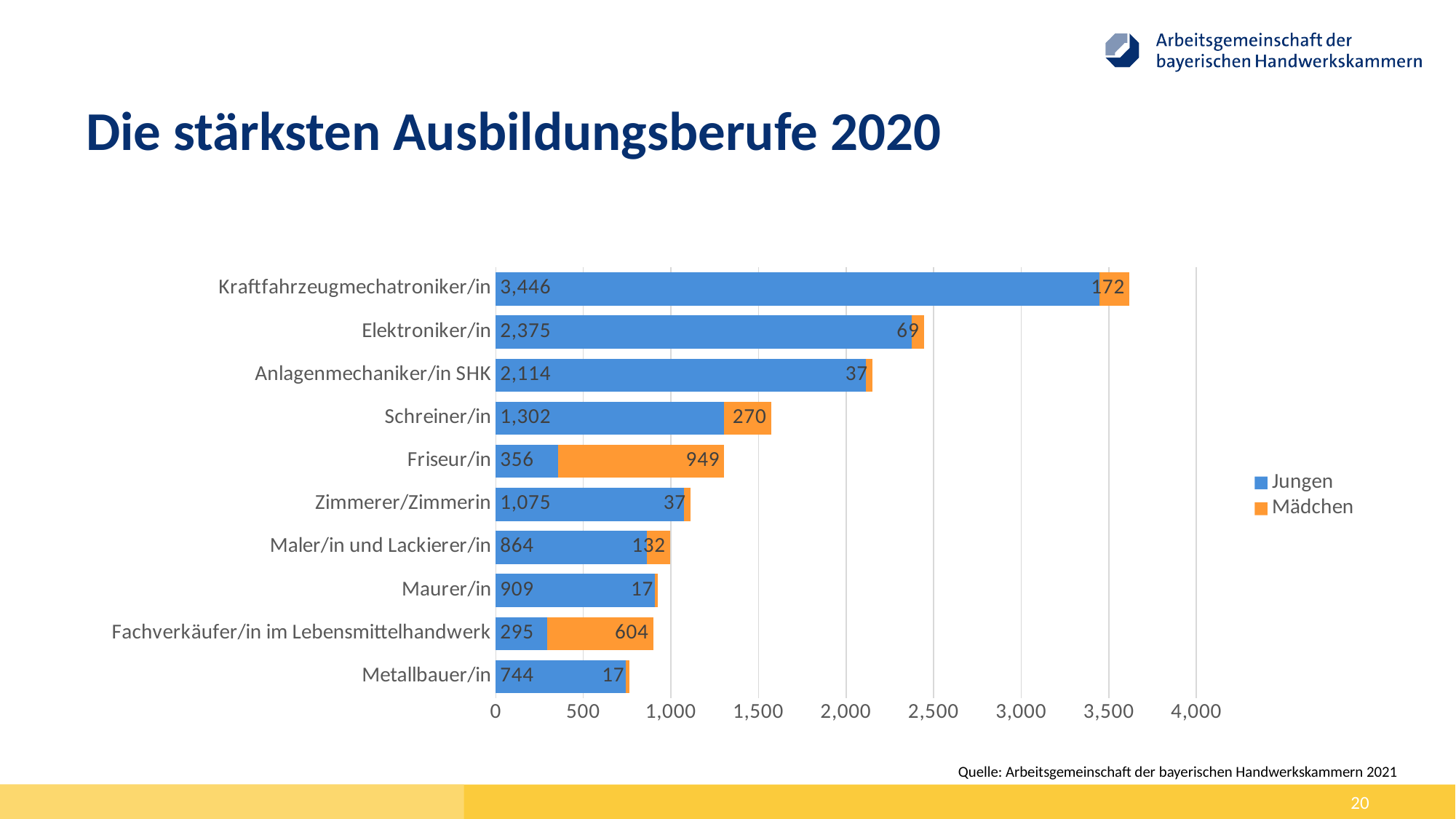
Is the total bar length for Zimmerer/Zimmerin greater or less than 1,000? greater Which category has the highest Mädchen value? Friseur/in What is the Mädchen value for Friseur/in? 949 What is the Jungen value for Fachverkäufer/in im Lebensmittelhandwerk? 295 How many series does the legend list? 2 What is the Jungen value for Kraftfahrzeugmechatroniker/in? 3,446 Which has the larger Jungen value, Maurer/in or Maler/in und Lackierer/in? Maurer/in What is the total (Jungen plus Mädchen) for Schreiner/in? 1,572 Which category has the lowest Jungen value? Fachverkäufer/in im Lebensmittelhandwerk What is the difference between the Jungen values for Elektroniker/in and Anlagenmechaniker/in SHK? 261 What kind of chart is shown on the slide? Stacked bar chart How many occupations are shown in the chart? 10